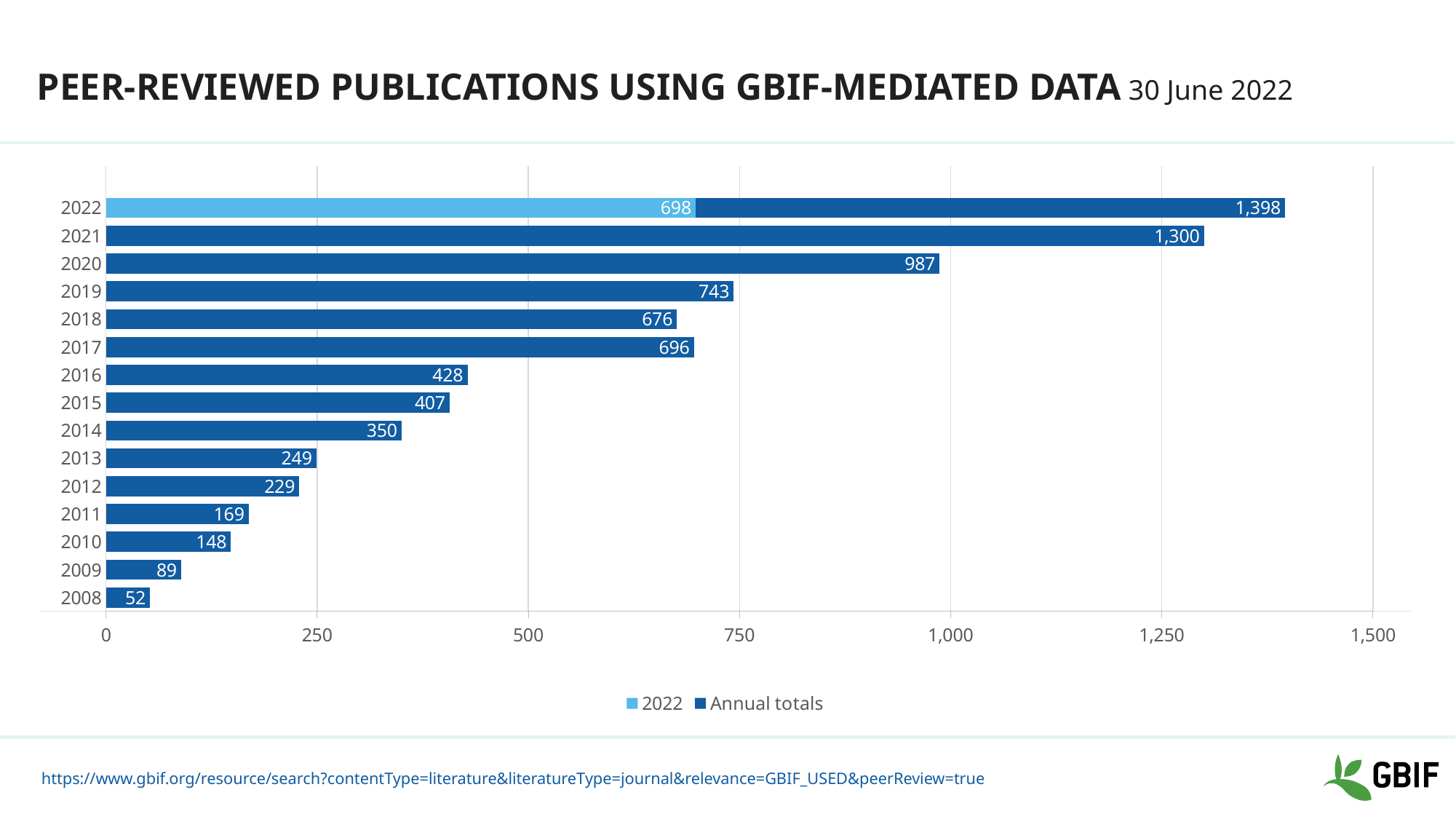
Which year has the longest bar in the chart? 2022 How many series does the legend list? 2 Which year has the larger value, 2017 or 2018? 2017 What type of chart is shown on the slide? bar chart How many years are shown on the chart? 15 Which year has the lowest number of publications? 2008 What value is shown for the light-blue '2022' series segment? 698 Is the value for 2020 greater or less than 750? greater What value is labelled on the 'Annual totals' segment for 2022? 1,398 What is the annual total of peer-reviewed publications for 2021? 1,300 What is the difference between the annual totals for 2021 and 2020? 313 What value is shown for 2008? 52